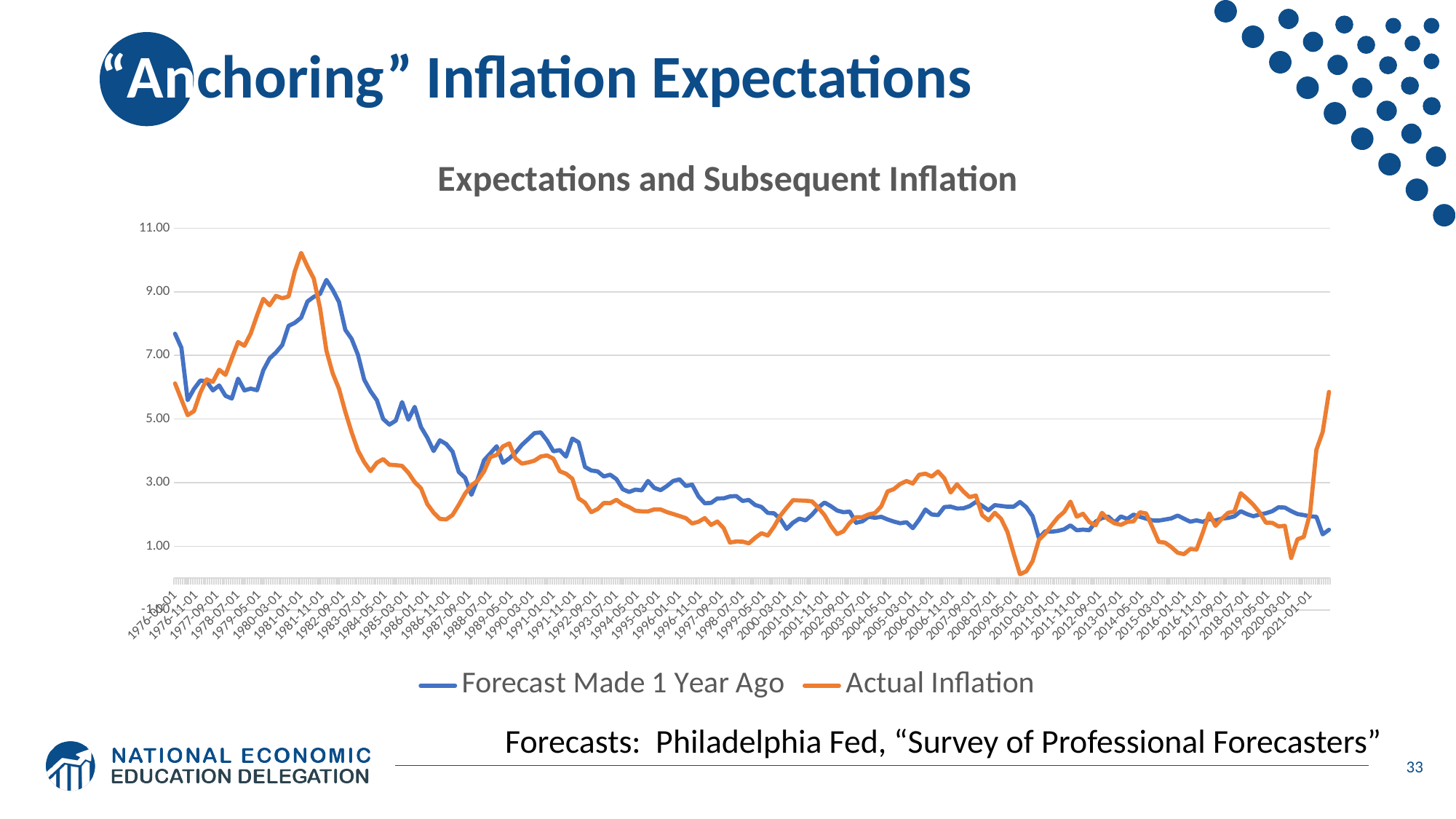
What is the title of the chart? Expectations and Subsequent Inflation Is the final value of Forecast Made 1 Year Ago at the right end of the chart greater or less than 3.00? less Which series reaches the higher peak in the early 1980s, Forecast Made 1 Year Ago or Actual Inflation? Actual Inflation Is the value of Forecast Made 1 Year Ago at the start of the chart (1976) greater or less than 7.00? greater Is the value of Actual Inflation at its lowest point around 2009-2010 greater or less than 1.00? less Which series is drawn in orange? Actual Inflation Do the values of Forecast Made 1 Year Ago generally rise or fall between 1982 and 2000? fall How many series does the legend list? 2 What kind of chart is shown on the slide? Line chart At the right end of the chart (2021), which series is higher, Forecast Made 1 Year Ago or Actual Inflation? Actual Inflation